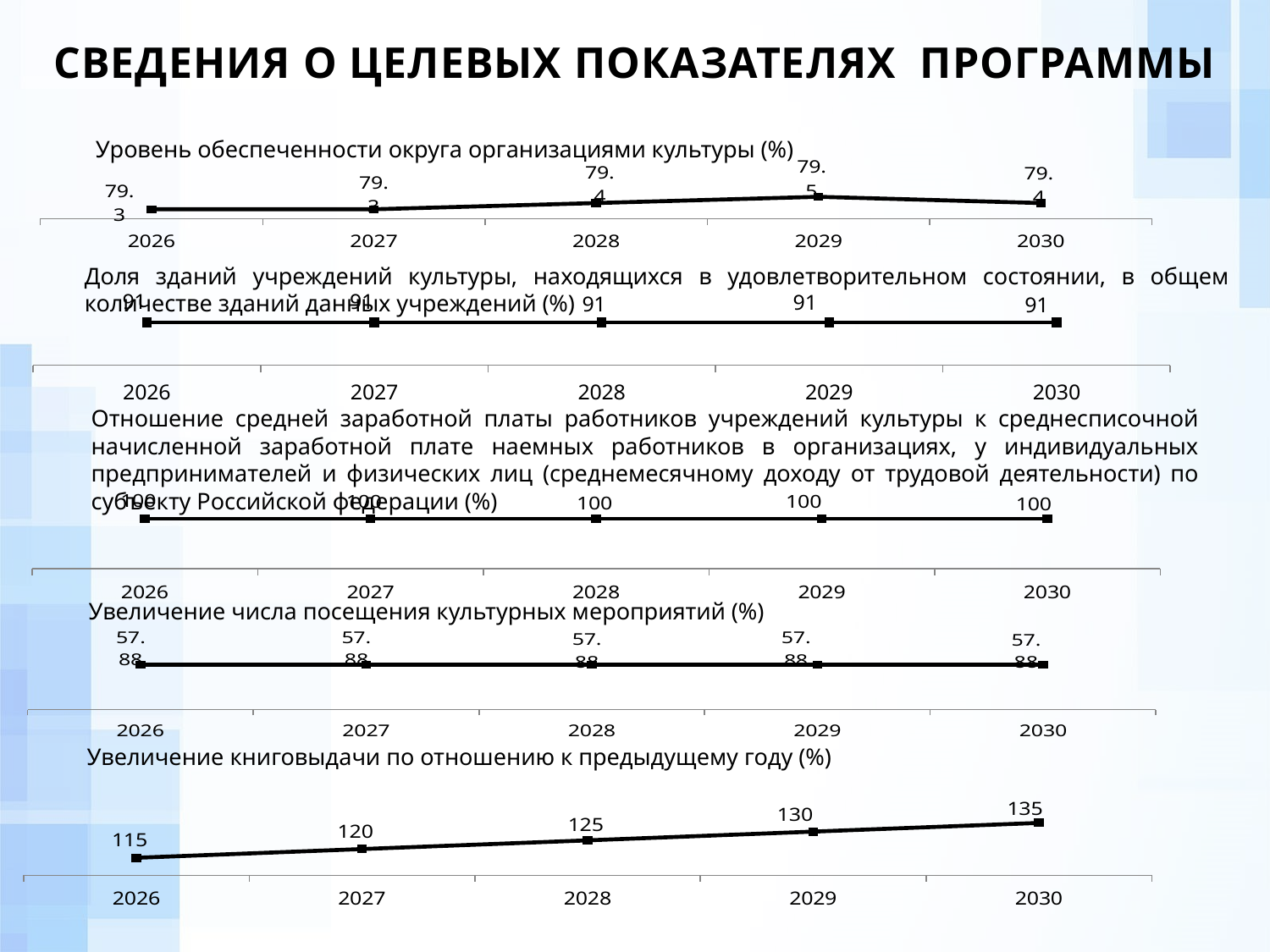
In the chart 'Увеличение книговыдачи по отношению к предыдущему году (%)', what is the difference between the values for 2030 and 2026? 20 In the chart 'Увеличение книговыдачи по отношению к предыдущему году (%)', what is the value for 2026? 115 In the chart 'Увеличение книговыдачи по отношению к предыдущему году (%)', which year has the highest value? 2030 In the chart 'Доля зданий учреждений культуры, находящихся в удовлетворительном состоянии...', what is the value for 2028? 91 In the chart 'Увеличение книговыдачи по отношению к предыдущему году (%)', do the values rise or fall from 2026 to 2030? rise In the chart 'Увеличение книговыдачи по отношению к предыдущему году (%)', which year has the lowest value? 2026 In the chart 'Уровень обеспеченности округа организациями культуры (%)', which year has the highest value? 2029 In the chart 'Увеличение книговыдачи по отношению к предыдущему году (%)', what is the value for 2030? 135 In the chart 'Увеличение числа посещения культурных мероприятий (%)', what is the value for 2027? 57.88 In the chart 'Уровень обеспеченности округа организациями культуры (%)', what is the value for 2029? 79.5 What type of chart is 'Увеличение книговыдачи по отношению к предыдущему году (%)'? line chart In the chart 'Увеличение книговыдачи по отношению к предыдущему году (%)', how many years are plotted? 5